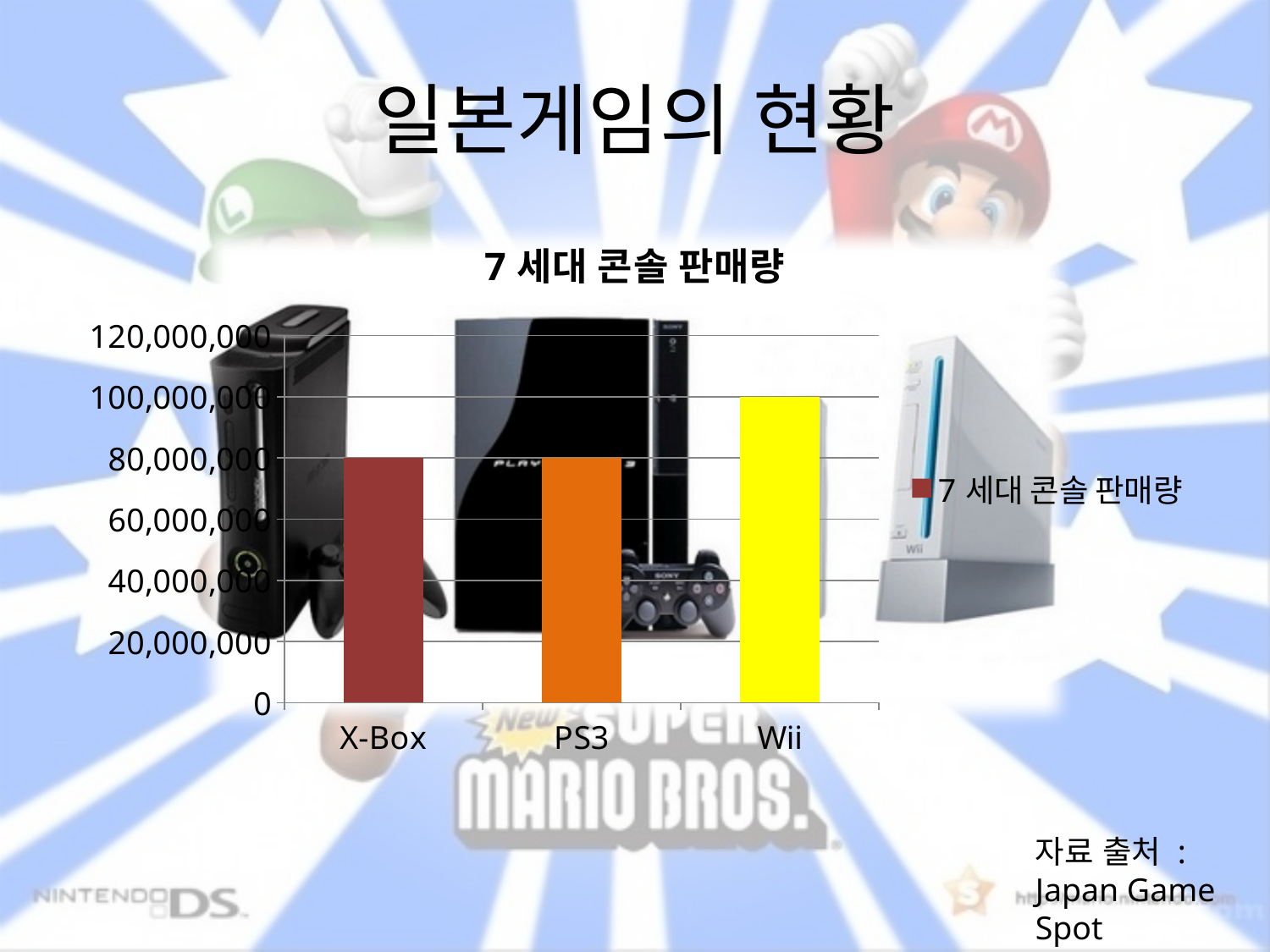
What colour is the bar for Wii? yellow Which is larger, the value for Wii or the value for PS3? Wii What is the value for PS3 in the chart? 80,000,000 What is the value for X-Box in the chart? 80,000,000 What is the value for Wii in the chart? 100,000,000 How many consoles are shown on the x axis of the chart? 3 Is the value for Wii greater or less than 120,000,000? less Which console has the highest sales in the chart? Wii What is the difference between the value for Wii and the value for X-Box? 20,000,000 What kind of chart is shown on the slide? bar chart How many series does the chart legend list? 1 What is the title of the chart? 7 세대 콘솔 판매량